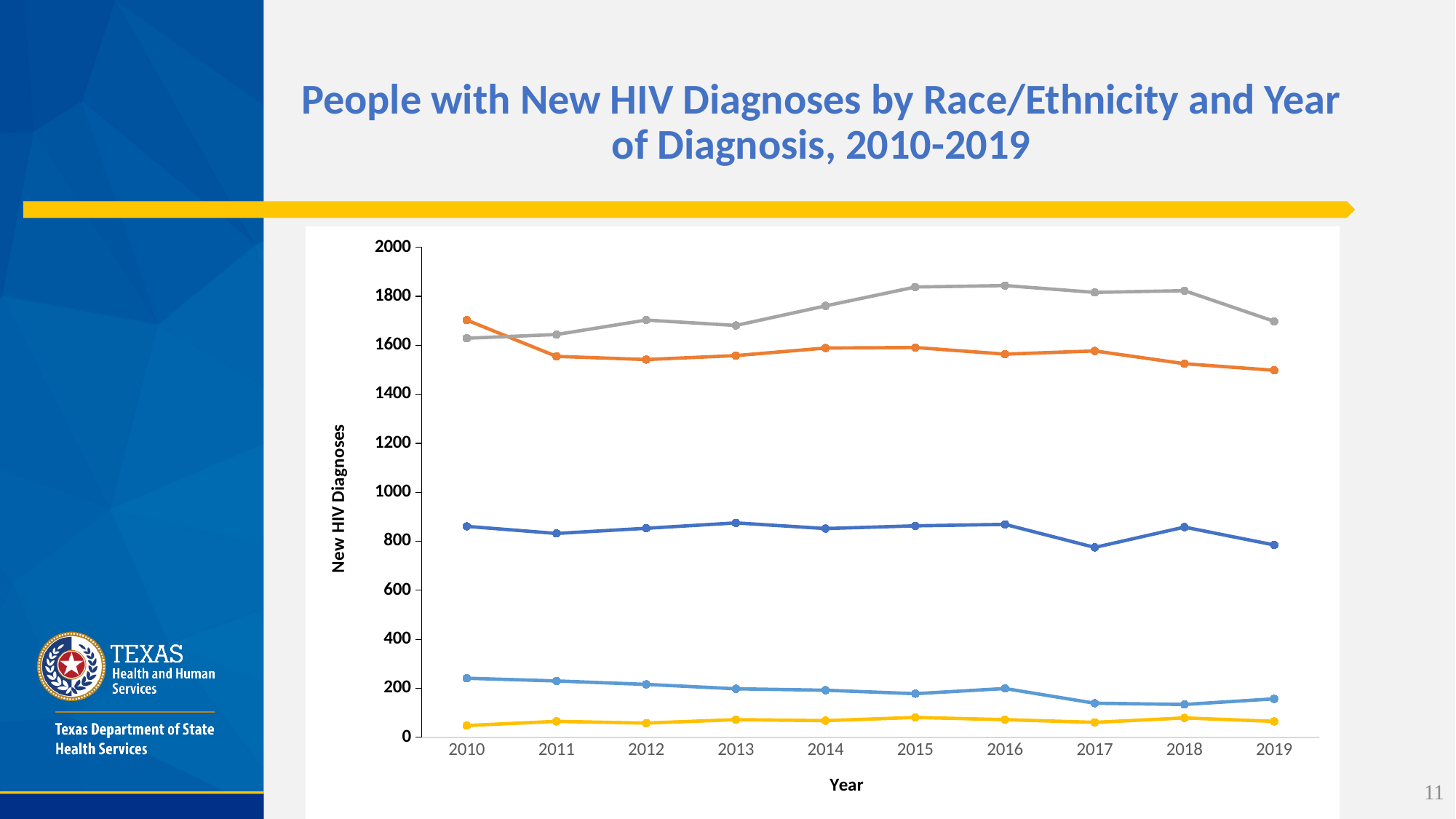
In 2010, which line is higher, the orange line or the gray line? orange line How many lines are plotted on the chart? 5 What kind of chart is shown on the slide? line chart How many years are shown along the x axis of the chart? 10 Is the value of the orange line in 2019 greater or less than 1600? less What is the title of the x axis? Year Is the value of the dark blue line in 2013 greater or less than 800? greater What is the title of the y axis? New HIV Diagnoses In 2019, which line is higher, the gray line or the orange line? gray line Is the value of the gray line in 2010 greater or less than 1800? less Which line has the lowest values across all years? yellow line